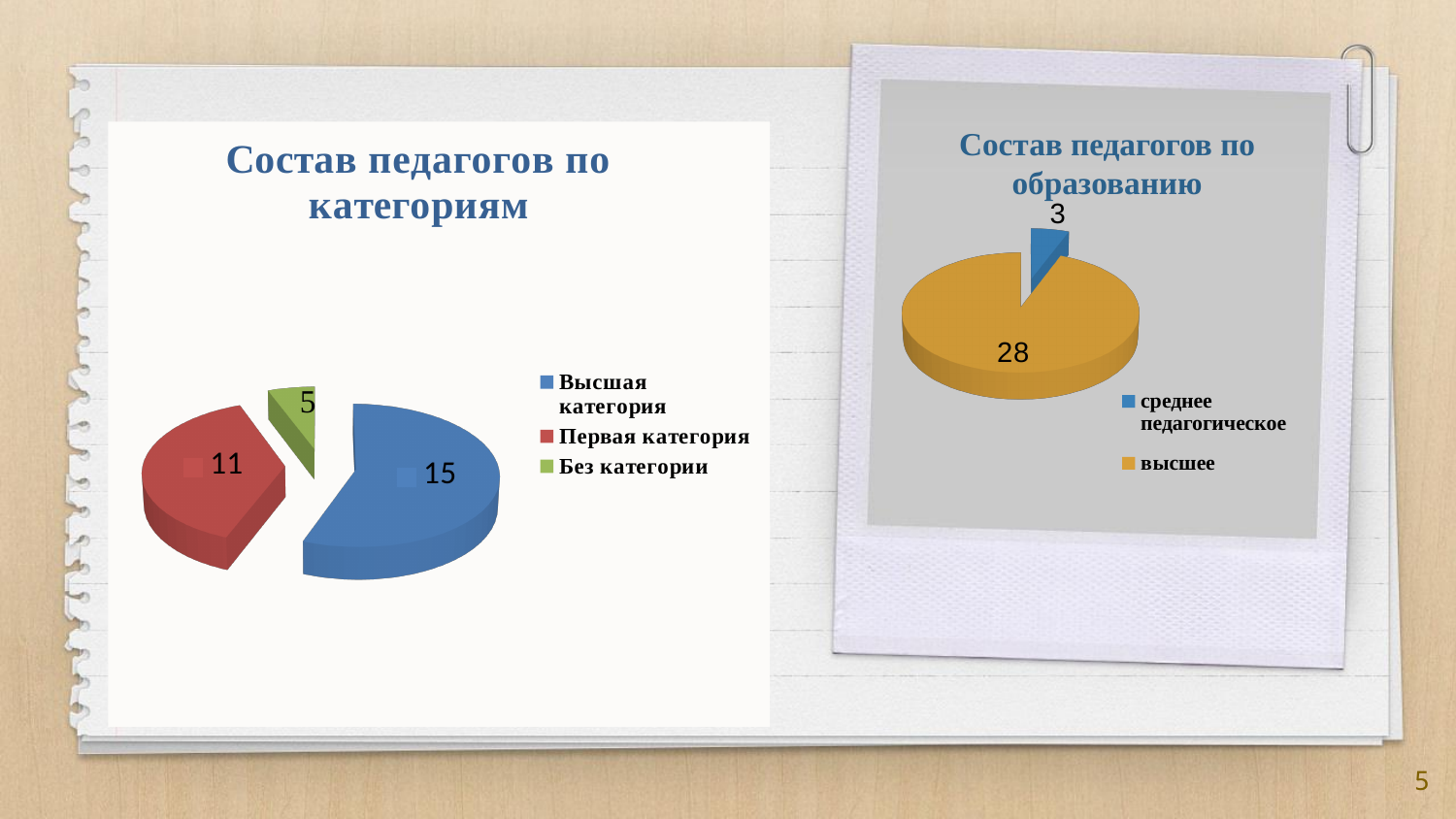
In the chart titled 'Состав педагогов по образованию', what is the difference between 'высшее' and 'среднее педагогическое'? 25 In the chart titled 'Состав педагогов по категориям', what is the value for 'Первая категория'? 11 In the chart titled 'Состав педагогов по образованию', what is the value for 'среднее педагогическое'? 3 In the chart titled 'Состав педагогов по категориям', what is the value for 'Высшая категория'? 15 What kind of chart is 'Состав педагогов по категориям'? Pie chart In the chart titled 'Состав педагогов по категориям', what is the value for 'Без категории'? 5 In the chart titled 'Состав педагогов по категориям', which category has the smallest slice? Без категории In the chart titled 'Состав педагогов по образованию', what is the value for 'высшее'? 28 In the chart titled 'Состав педагогов по категориям', which category has the largest slice? Высшая категория In the chart titled 'Состав педагогов по образованию', which is larger, 'высшее' or 'среднее педагогическое'? высшее In the chart titled 'Состав педагогов по категориям', how many categories are shown? 3 In the chart titled 'Состав педагогов по категориям', what is the difference between 'Высшая категория' and 'Первая категория'? 4